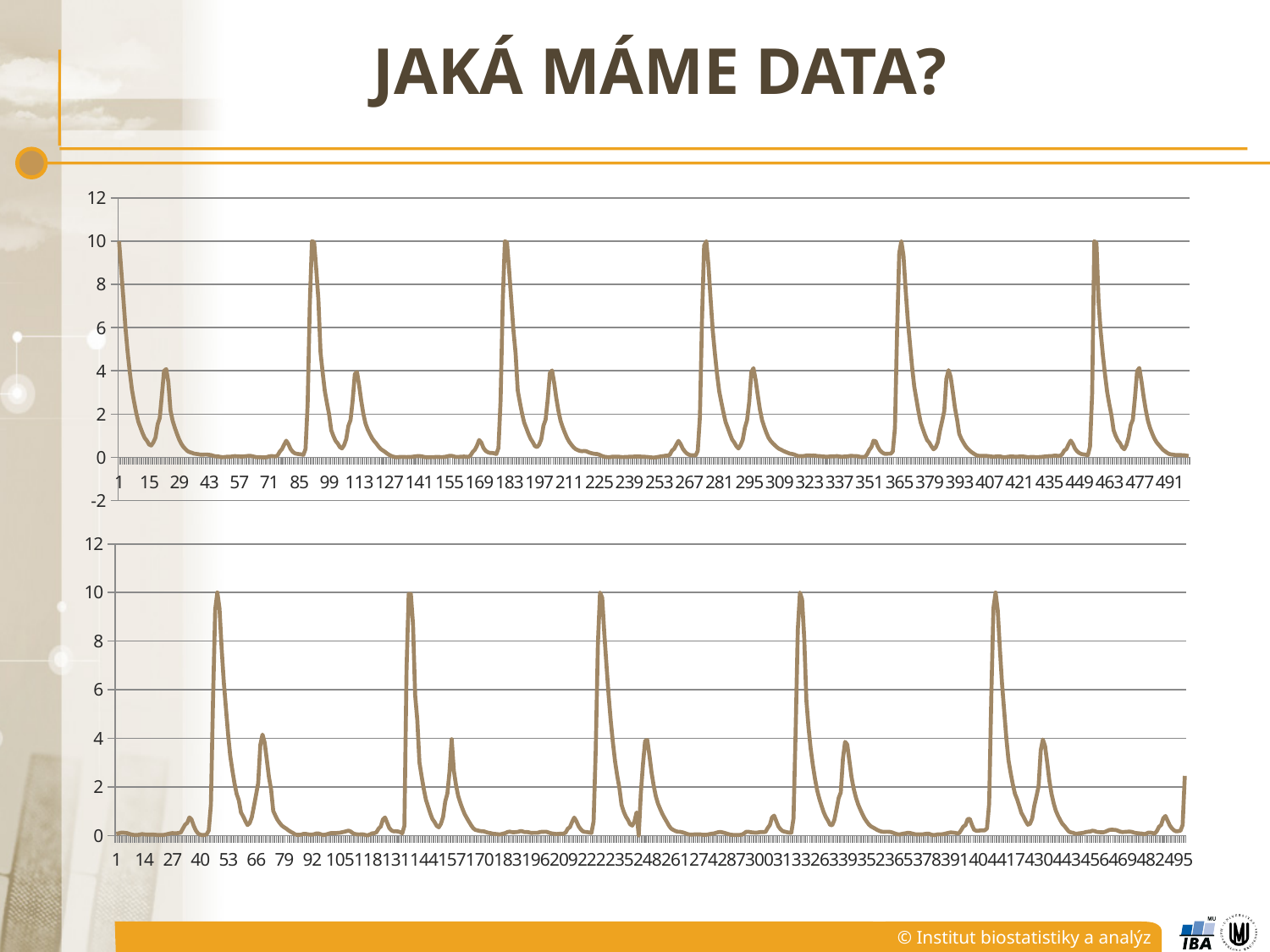
In the top chart, is the value at the first point (x = 1) greater or less than 8? greater In the bottom chart, how many peaks reach the 10 gridline? 5 In the top chart, are the smaller secondary peaks that follow each main peak greater or less than 6? less What is the lowest tick label on the vertical axis of the top chart? -2 In the top chart, how many peaks reach the 10 gridline? 6 How many charts are shown on the slide? 2 In the bottom chart, are the smaller secondary peaks that follow each main peak greater or less than 2? greater What kind of chart is the top chart on the slide? line chart What is the last label on the horizontal axis of the bottom chart? 495